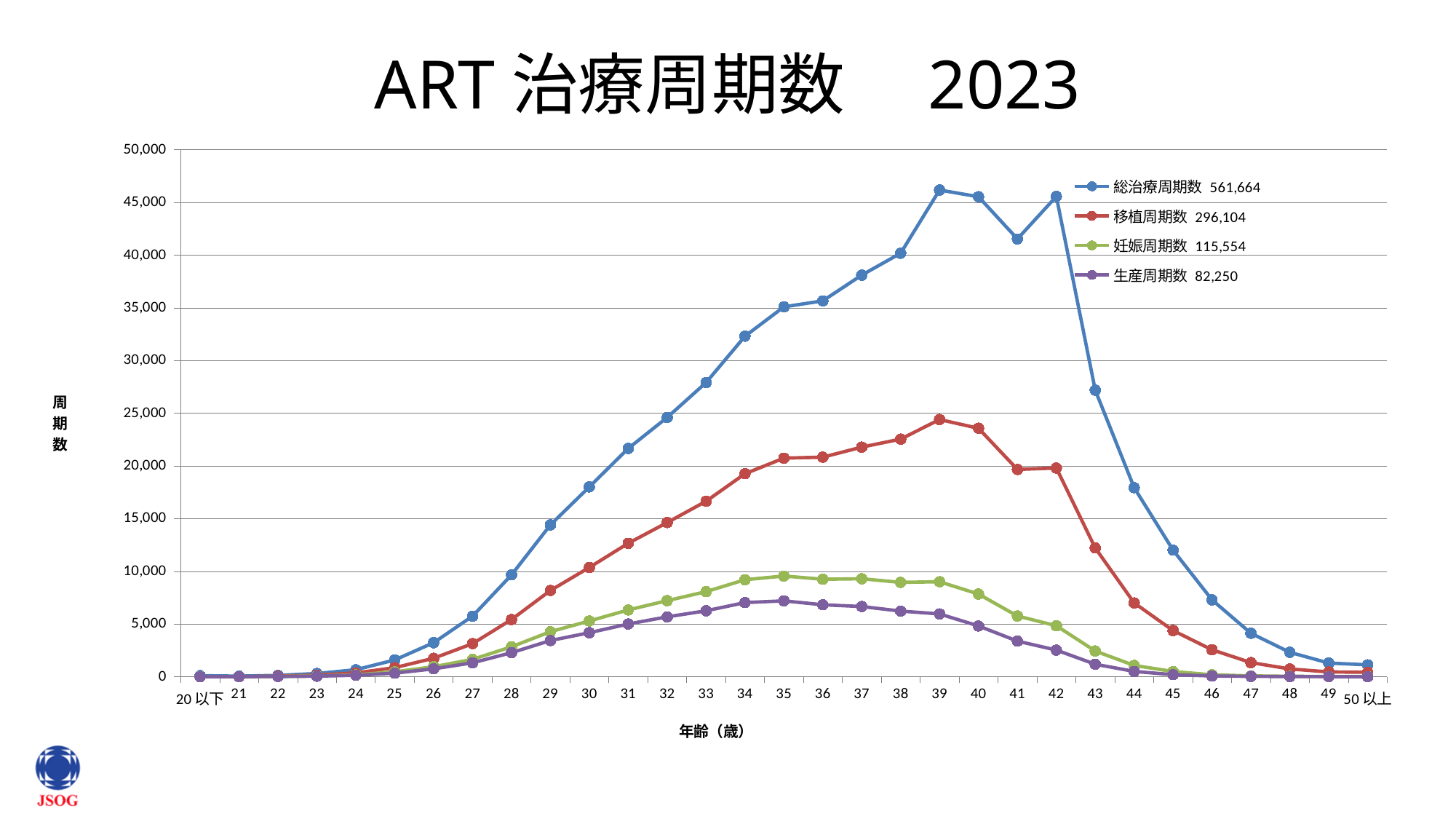
What total is printed in the legend for 生産周期数? 82,250 How many age categories are plotted along the x axis? 31 Is the value of 妊娠周期数 at age 40 greater or less than 5,000? greater How many series does the legend list? 4 Do the 総治療周期数 values rise or fall from age 42 to 50以上? fall What total is printed in the legend for 総治療周期数? 561,664 What is the title of the chart? ART 治療周期数 2023 Is the value of 総治療周期数 at age 30 greater or less than 15,000? greater What kind of chart is shown on the slide? line chart Which is larger, the 総治療周期数 value at age 41 or at age 42? age 42 Is the value of 総治療周期数 at age 43 greater or less than 25,000? greater What total is printed in the legend for 移植周期数? 296,104